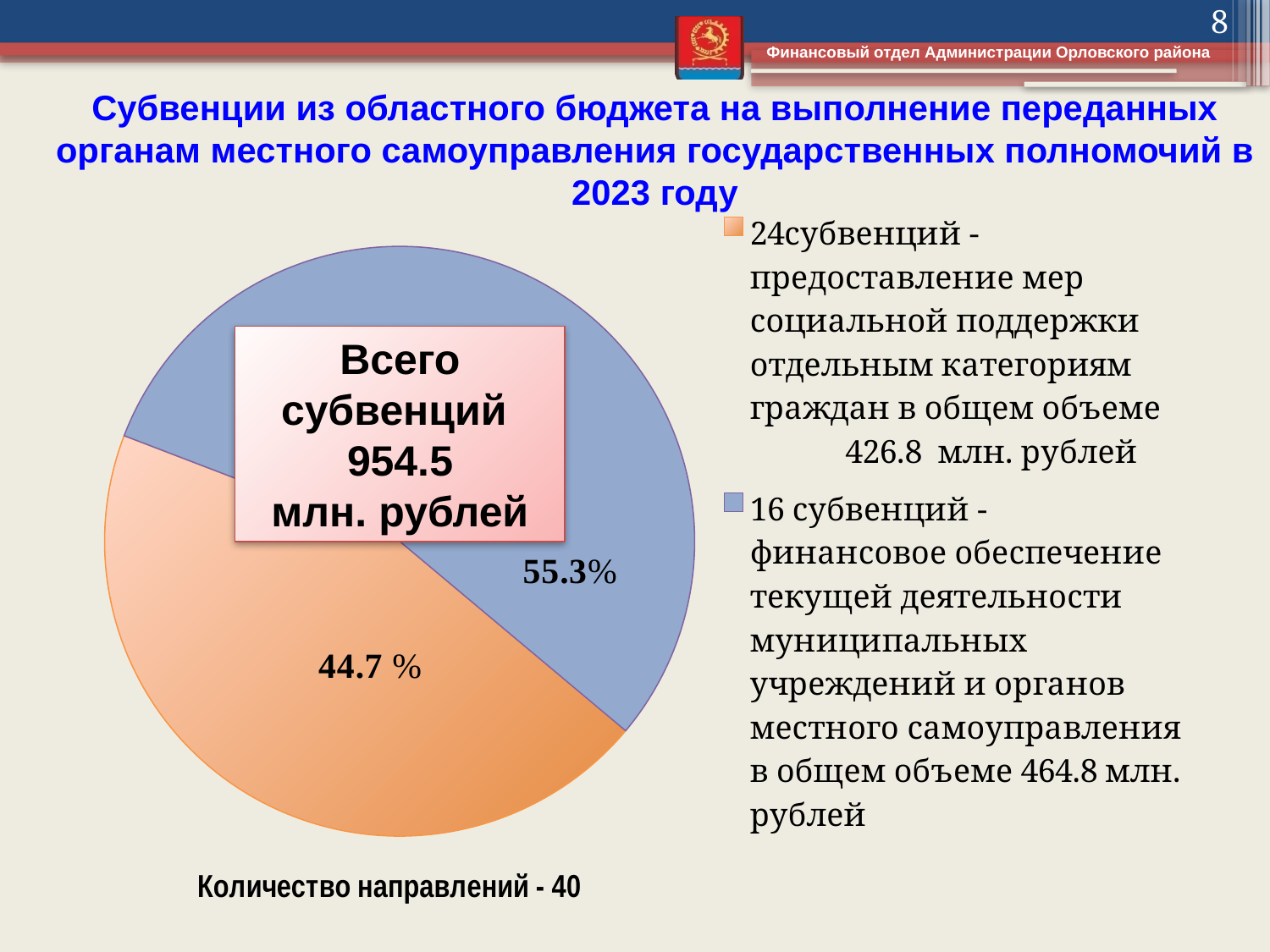
Which category has the largest share of the pie? 16 субвенций - финансовое обеспечение текущей деятельности муниципальных учреждений и органов местного самоуправления What share of the pie does the orange slice (24 субвенций - предоставление мер социальной поддержки) represent? 44.7 % How many slices does the pie chart have? 2 How many entries does the legend of the pie chart list? 2 What share of the pie does the blue slice (16 субвенций - финансовое обеспечение текущей деятельности муниципальных учреждений) represent? 55.3% By how many percentage points does the blue slice (55.3%) exceed the orange slice (44.7 %)? 10.6 percentage points Which category has the smallest share of the pie? 24 субвенций - предоставление мер социальной поддержки отдельным категориям граждан What kind of chart is shown on the slide? pie chart What is the amount for the 16 субвенций on financial support of municipal institutions (финансовое обеспечение текущей деятельности) according to the legend? 464.8 млн. рублей What is the total amount of subventions shown in the centre of the pie chart? 954.5 млн. рублей Which slice of the pie is larger: the blue one (16 субвенций) or the orange one (24 субвенций)? the blue one (16 субвенций) What is the amount for the 24 субвенций on social support (предоставление мер социальной поддержки) according to the legend? 426.8 млн. рублей